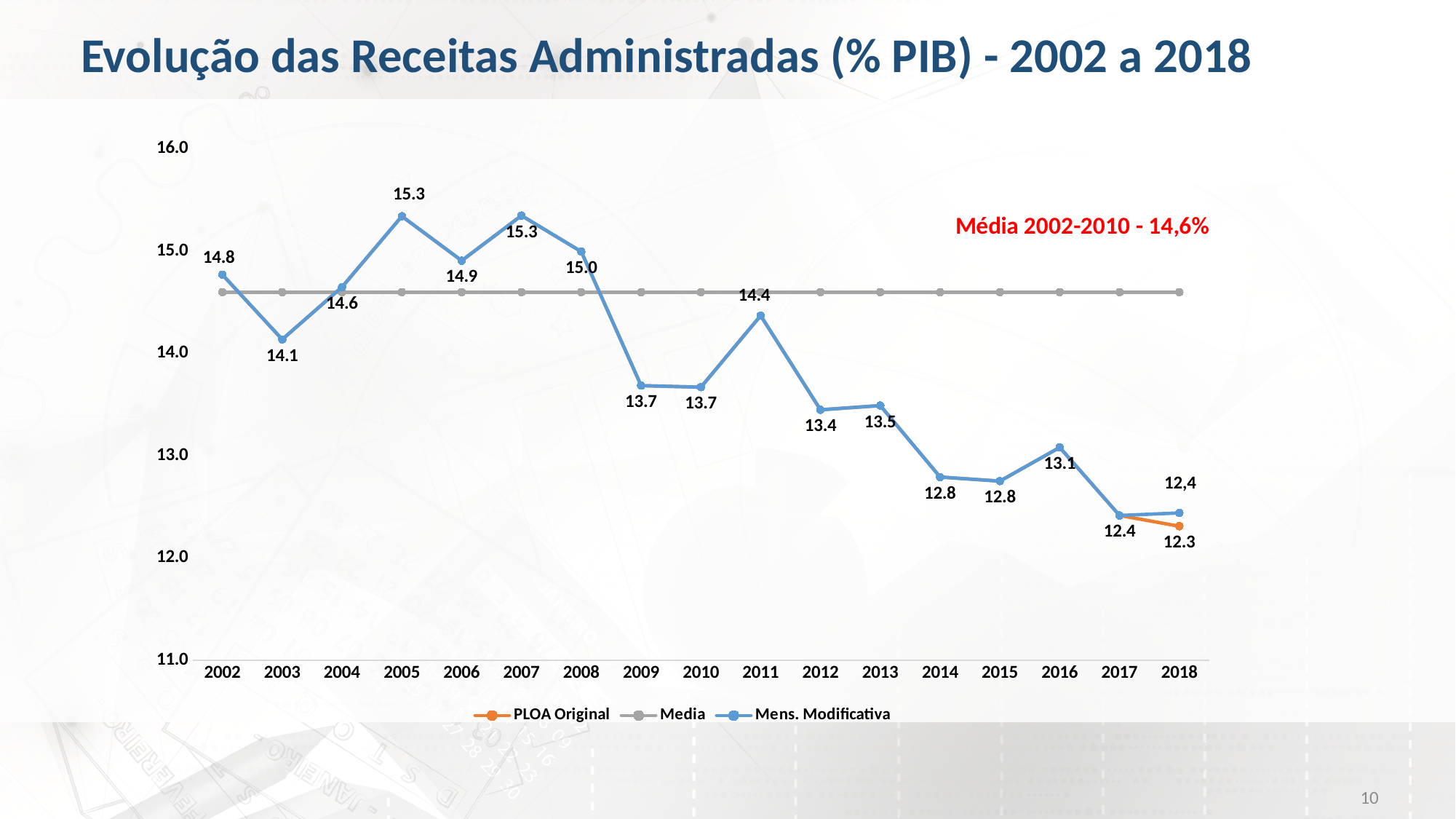
What is the PLOA Original value for 2018? 12.3 What is the Mens. Modificativa value for 2014? 12.8 How many years are shown on the x axis? 17 What kind of chart is shown on the slide? line chart What is the difference between the Mens. Modificativa values for 2002 and 2018? 2.4 What is the Mens. Modificativa value for 2009? 13.7 By how much did the Mens. Modificativa value fall from 2008 to 2009? 1.3 Is the Media line greater or less than 14.0? greater What is the Mens. Modificativa value for 2005? 15.3 Which year has the larger Mens. Modificativa value, 2011 or 2012? 2011 How many series does the legend list? 3 What value does the red annotation give for the Média 2002-2010? 14,6%